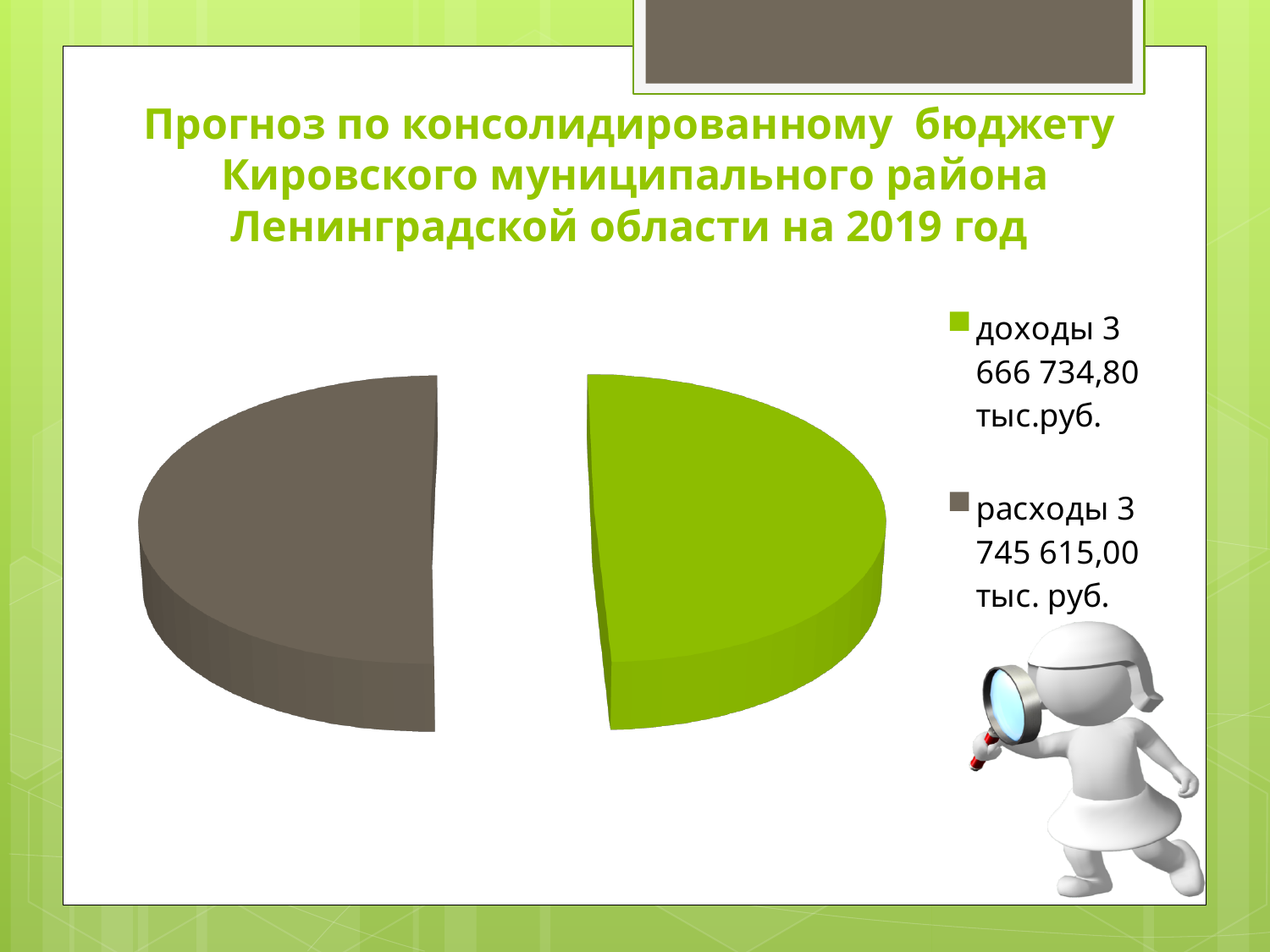
How many slices does the pie chart have? 2 Which category has the smallest value in the pie chart? доходы What is the difference between расходы and доходы in тыс. руб.? 78 880,20 What year does the chart title say the budget forecast is for? 2019 How many entries does the legend list? 2 What is the value for доходы according to the legend? 3 666 734,80 тыс.руб. What colour is the slice for доходы? green What kind of chart is shown on the slide? pie chart Which category has the larger value, доходы or расходы? расходы Which category has the largest value in the pie chart? расходы What is the value for расходы according to the legend? 3 745 615,00 тыс. руб.